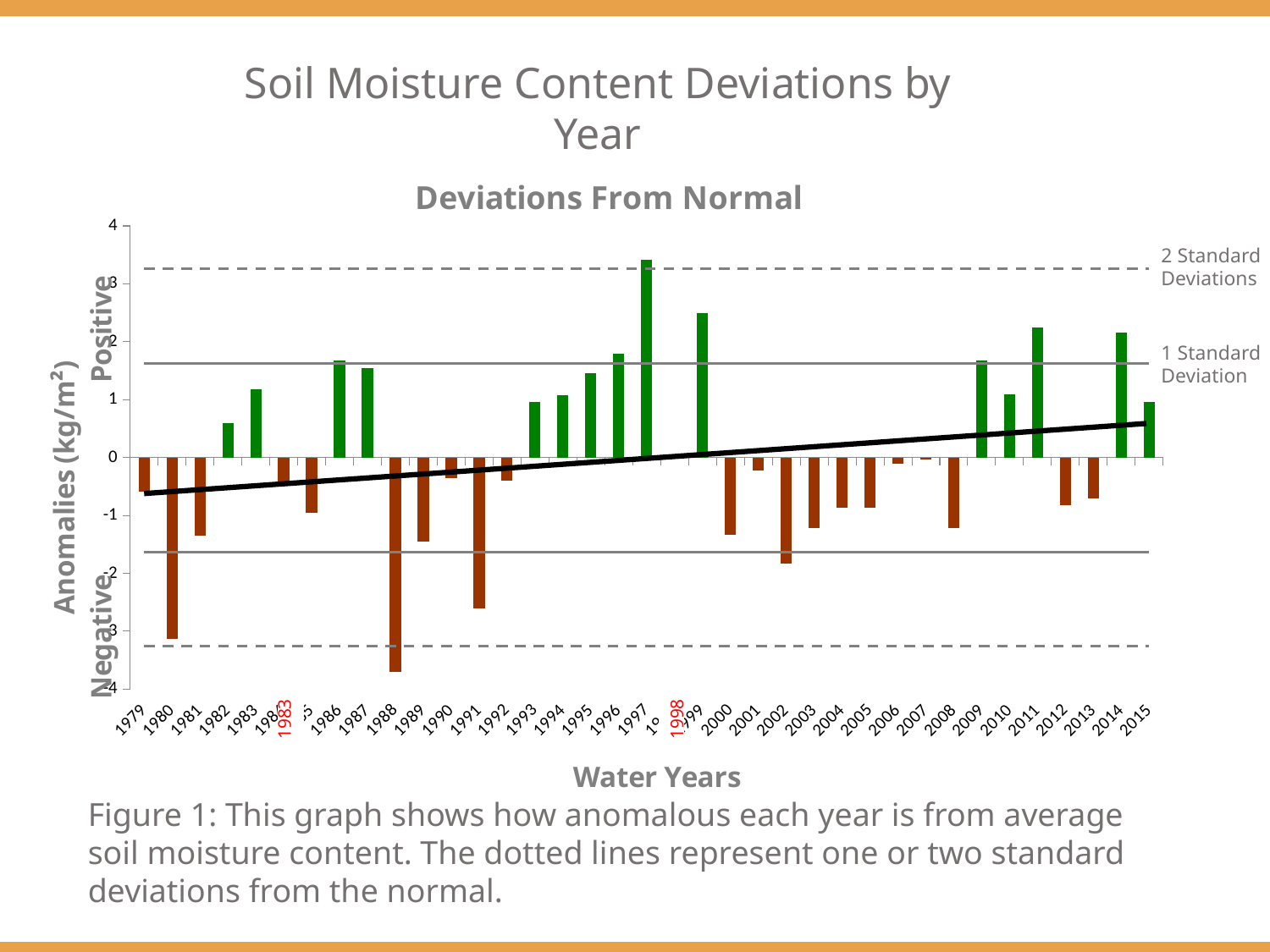
Does the black trend line rise or fall from 1979 to 2015? rises Is the value for 1980 greater or less than -2? less How many years are plotted on the x axis? 37 What kind of chart is shown on the slide? bar chart Which year has the larger anomaly, 1997 or 1999? 1997 Is the value for 2002 greater or less than -1? less What is the title of the x axis? Water Years Is the value for 1999 greater or less than 2? greater Which year has the highest soil moisture anomaly? 1997 Which year has the lowest (most negative) soil moisture anomaly? 1988